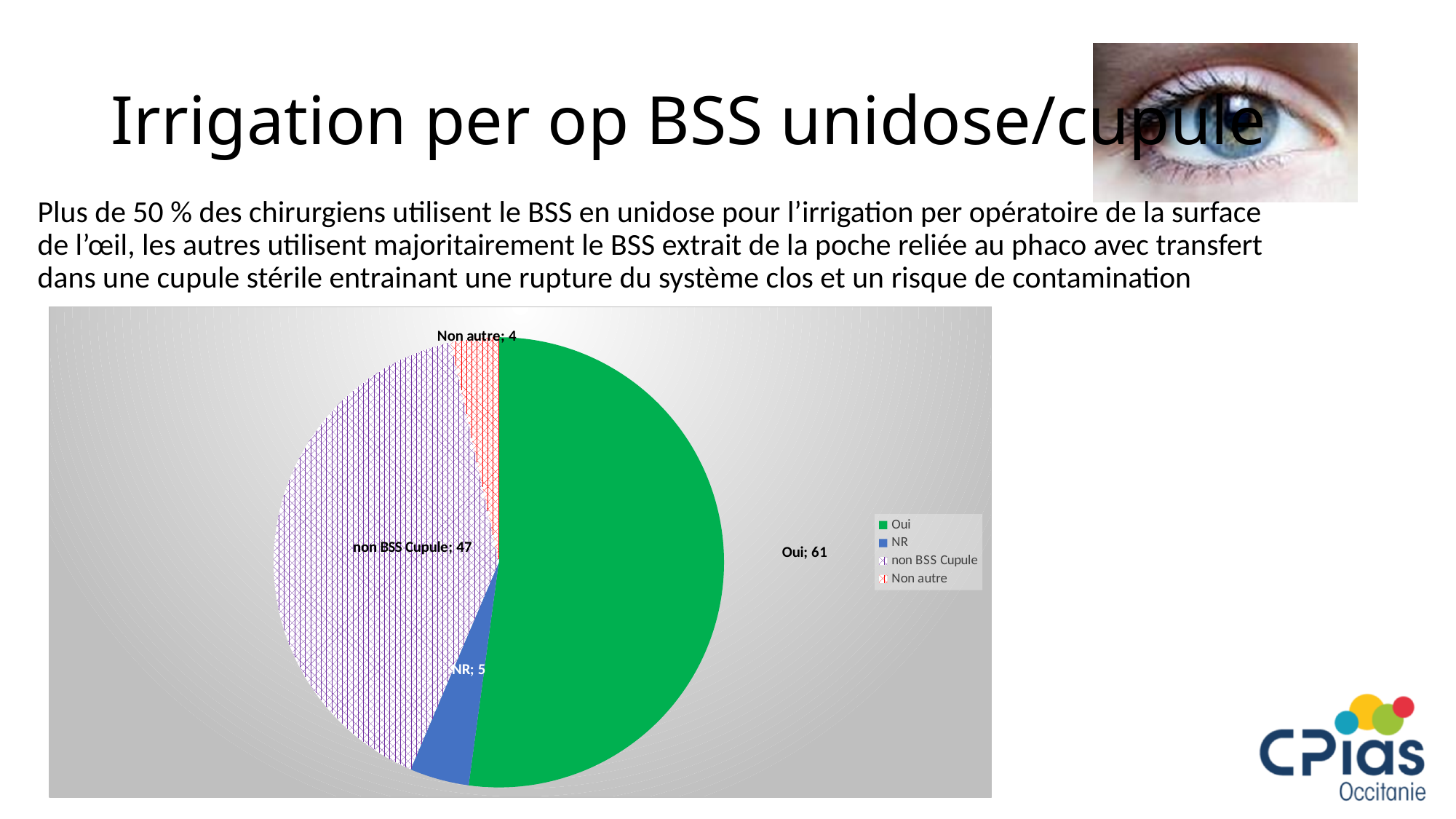
How many entries does the legend list? 4 What is the value for the 'Oui' slice? 61 What is the value for the 'Non autre' slice? 4 What colour is the 'Oui' slice? green Which is larger, the 'NR' value or the 'Non autre' value? NR What is the difference between the 'Oui' value and the 'non BSS Cupule' value? 14 How many slices does the pie chart have? 4 What kind of chart is shown on the slide? pie chart Which category has the largest slice of the pie? Oui What is the value for the 'non BSS Cupule' slice? 47 Which category has the smallest slice of the pie? Non autre What is the value for the 'NR' slice? 5